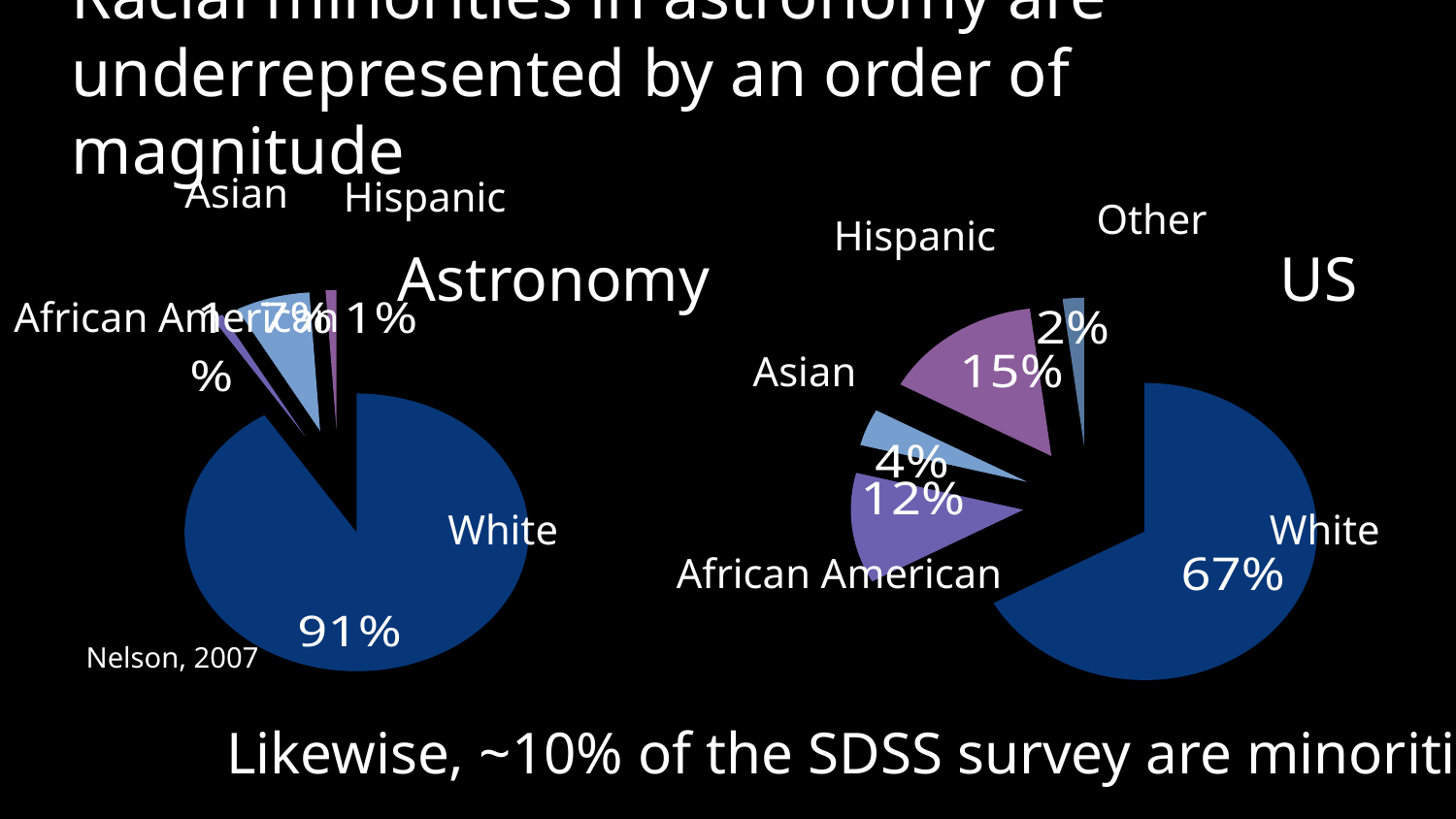
In the US pie chart, what percentage is shown for Other? 2% How many percentage points higher is the White share in the Astronomy pie chart than in the US pie chart? 24 percentage points In the US pie chart, what percentage is shown for Asian? 4% In the US pie chart, what percentage is shown for Hispanic? 15% How many categories are shown in the US pie chart? 5 In the US pie chart, what percentage is shown for White? 67% In the Astronomy pie chart, what percentage is shown for White? 91% In the US pie chart, what percentage is shown for African American? 12% In the US pie chart, which category has the smallest slice? Other In the US pie chart, which category has the largest slice? White In the US pie chart, which is larger, the Hispanic slice or the African American slice? Hispanic What kind of charts are shown on the slide? Pie charts